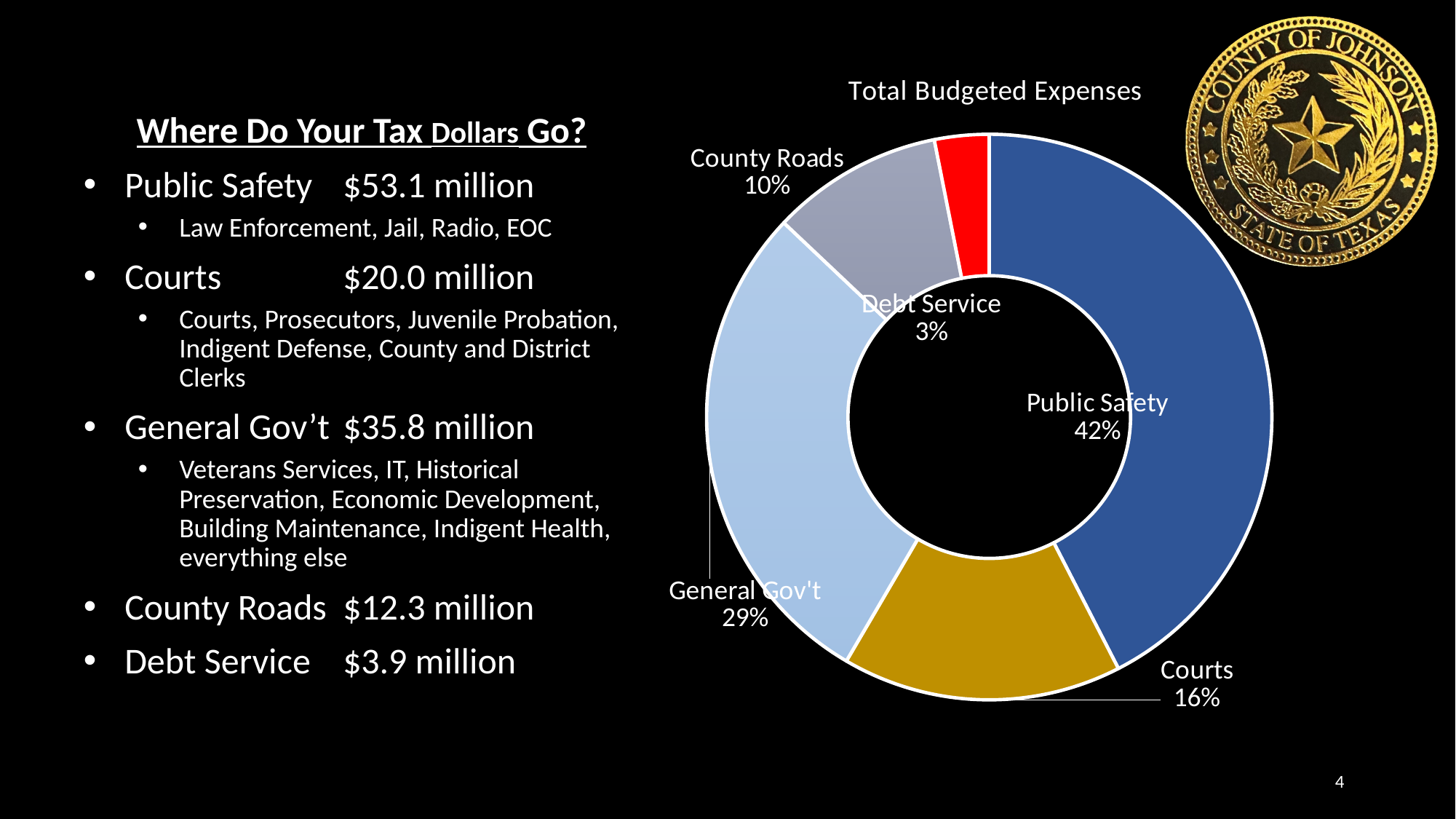
What share of Total Budgeted Expenses goes to Public Safety? 42% What is the title of the chart? Total Budgeted Expenses What share of Total Budgeted Expenses goes to Debt Service? 3% What share of Total Budgeted Expenses goes to General Gov't? 29% What kind of chart is shown on the slide? Doughnut chart How many categories are shown in the chart? 5 Which category has the largest share of Total Budgeted Expenses? Public Safety Which category has the smallest share of Total Budgeted Expenses? Debt Service What is the difference in percentage points between the Public Safety and General Gov't shares? 13 Which has a larger share, Courts or County Roads? Courts